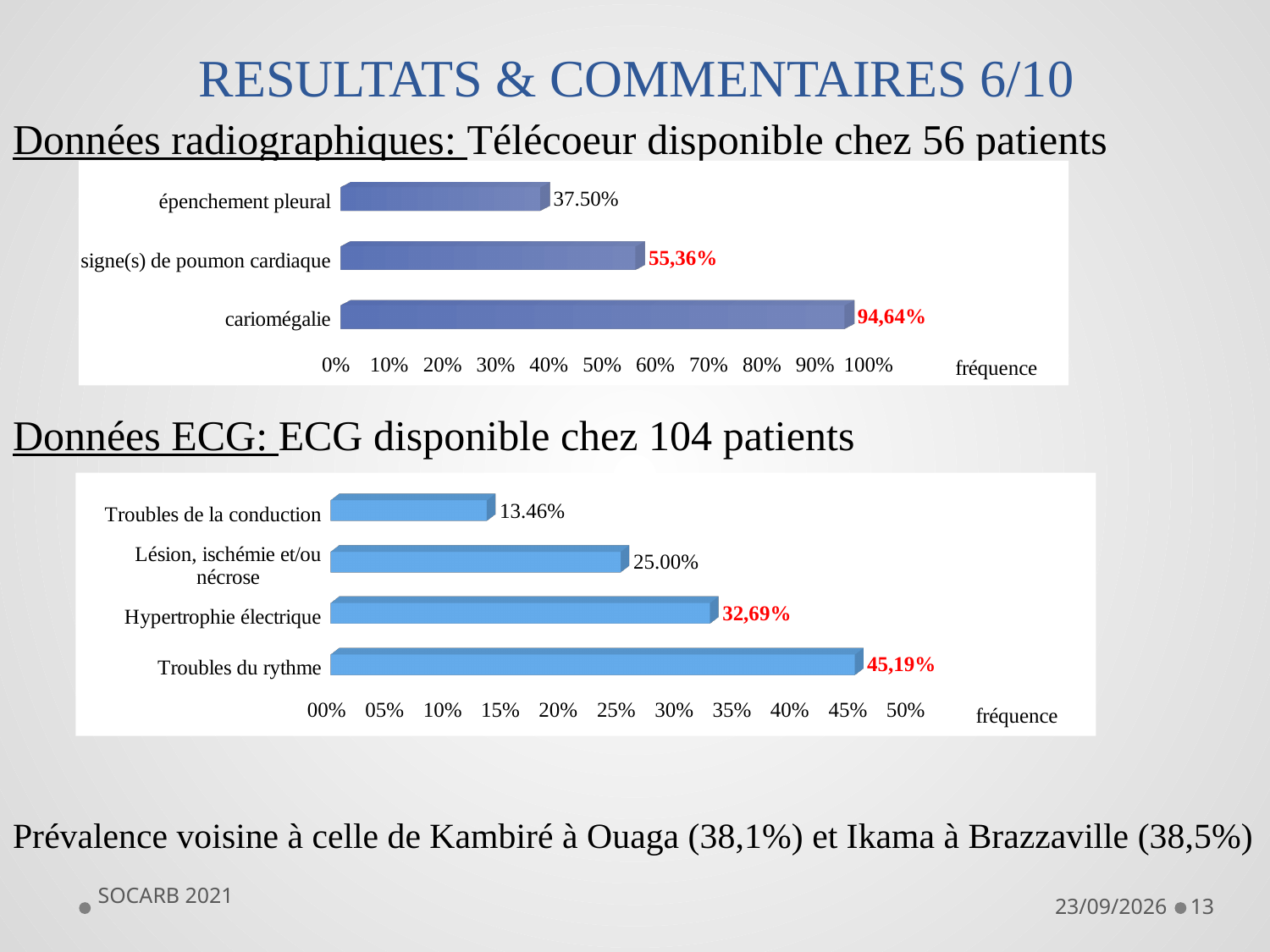
What kind of chart is the bottom chart (Données ECG)? Bar chart In the bottom chart (Données ECG), what is the value for Troubles de la conduction? 13.46% In the bottom chart (Données ECG), how many categories are shown? 4 In the top chart (Données radiographiques), what is the value for cariomégalie? 94,64% In the top chart (Données radiographiques), what is the value for épenchement pleural? 37.50% What is the x-axis label of the top chart (Données radiographiques)? fréquence In the top chart (Données radiographiques), which category has the lowest value? épenchement pleural In the bottom chart (Données ECG), which category has the highest value? Troubles du rythme In the top chart (Données radiographiques), is the value for signe(s) de poumon cardiaque greater or less than 50%? greater In the bottom chart (Données ECG), which is larger: Hypertrophie électrique or Lésion, ischémie et/ou nécrose? Hypertrophie électrique In the top chart (Données radiographiques), how many categories are shown? 3 In the bottom chart (Données ECG), what is the value for Troubles du rythme? 45,19%